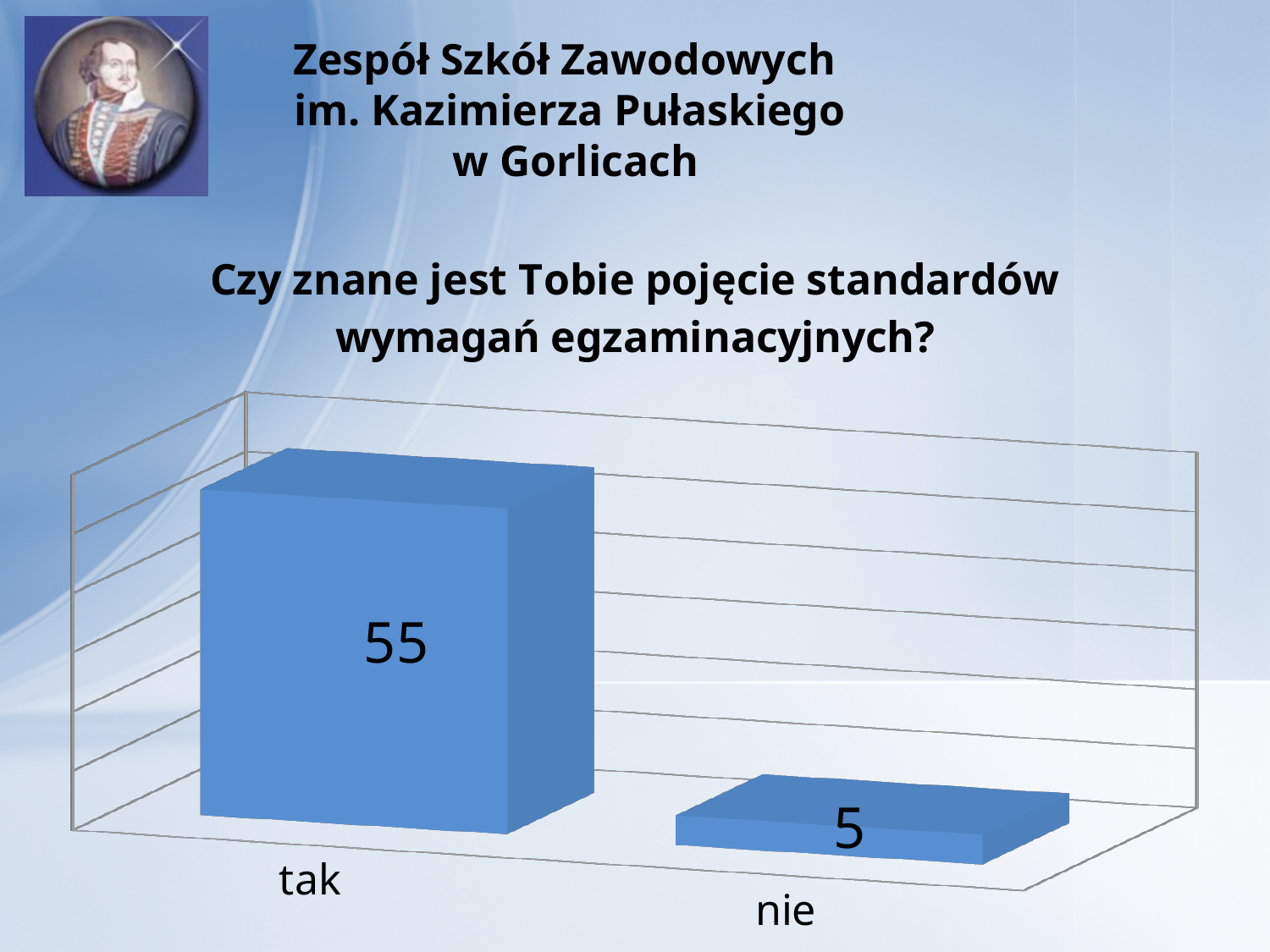
Which category has the highest value? tak What question does the chart title ask? Czy znane jest Tobie pojęcie standardów wymagań egzaminacyjnych? Which is larger, the value for "tak" or the value for "nie"? tak How many categories are shown in the chart? 2 Which category has the lowest value? nie What is the total of the values for "tak" and "nie"? 60 What is the value for "tak"? 55 What is the value for "nie"? 5 Do the values rise or fall from left to right along the x axis? fall What is the difference between the values for "tak" and "nie"? 50 What kind of chart is shown on the slide? bar chart